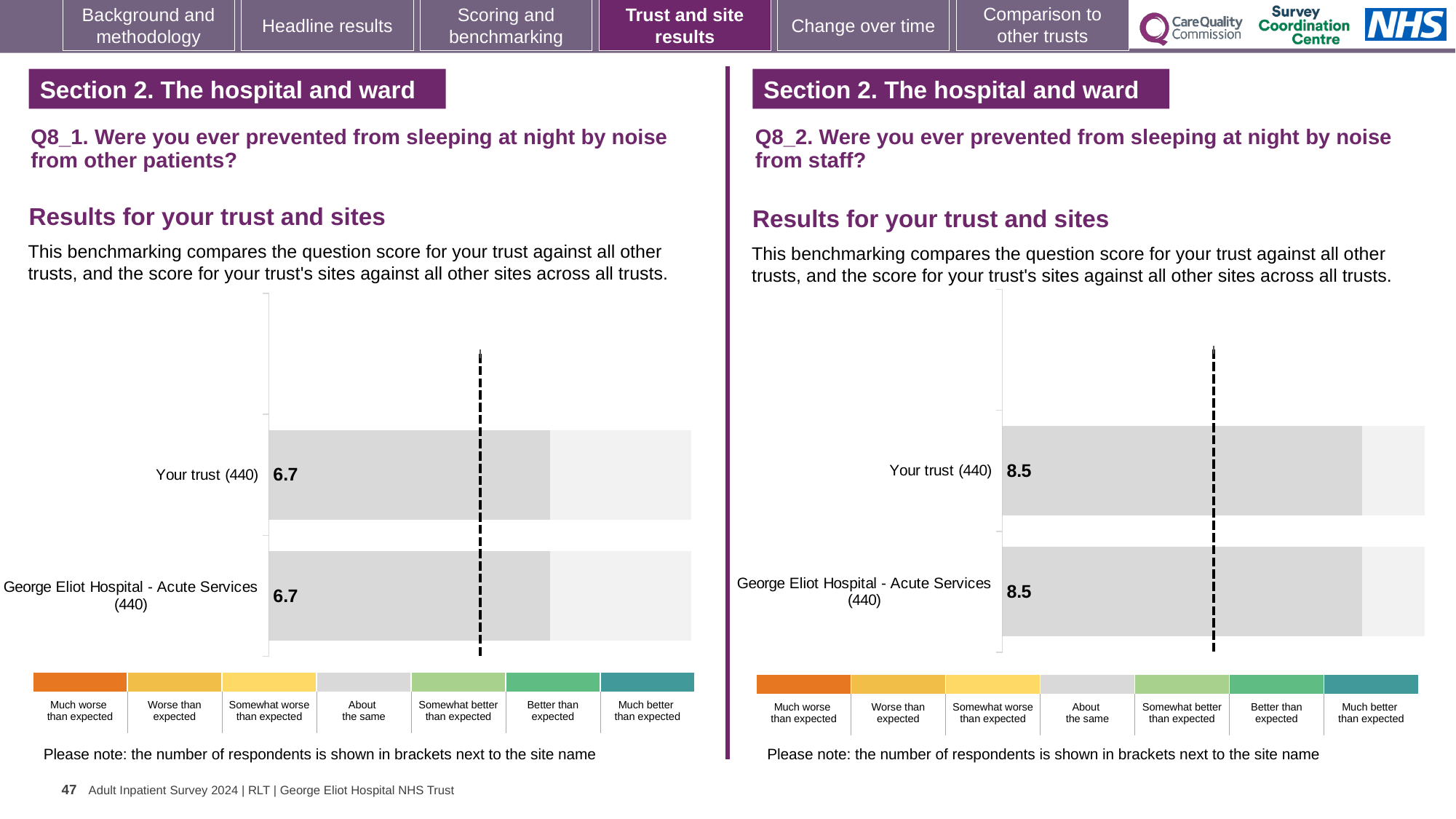
In the Q8_2 chart, what is the difference between the score for Your trust and the score for George Eliot Hospital - Acute Services? 0 What is the difference between the Your trust score in the Q8_2 chart and the Your trust score in the Q8_1 chart? 1.8 In the Q8_1 chart (noise from other patients), what is the score for Your trust (440)? 6.7 How many bars are plotted in the Q8_2 chart? 2 In the Q8_1 chart (noise from other patients), what is the score for George Eliot Hospital - Acute Services (440)? 6.7 Is the score for Your trust higher in the Q8_1 chart or the Q8_2 chart? Q8_2 chart What kind of chart is used for the Q8_2 results? Bar chart In the Q8_2 chart (noise from staff), what is the score for George Eliot Hospital - Acute Services (440)? 8.5 In the Q8_1 chart, what is the difference between the score for Your trust and the score for George Eliot Hospital - Acute Services? 0 In the Q8_1 chart, how many respondents are shown in brackets next to Your trust? 440 How many bars are plotted in the Q8_1 chart? 2 In the Q8_2 chart (noise from staff), what is the score for Your trust (440)? 8.5